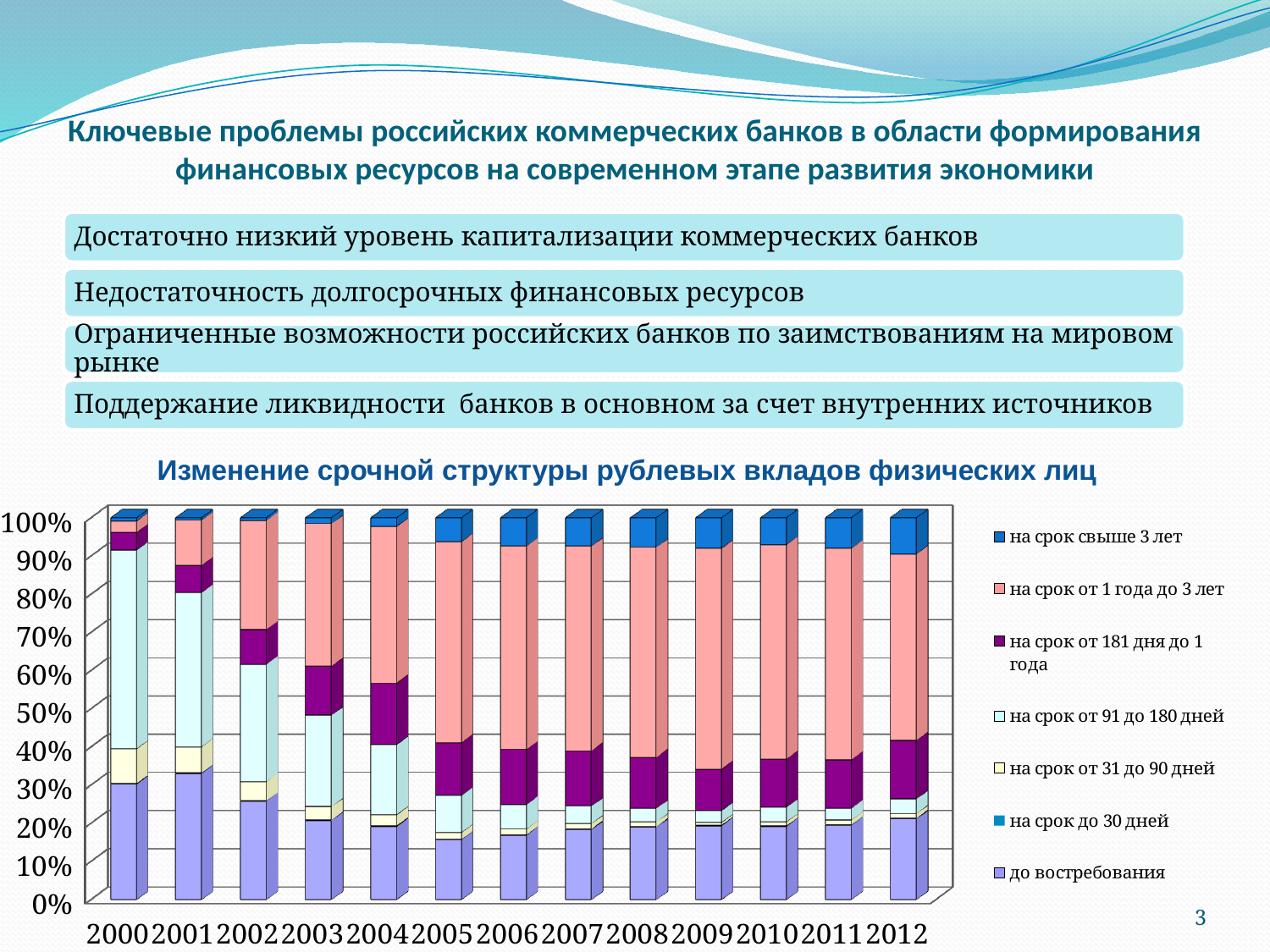
What is the total of the stacked bar for 2005? 100% What is the title of the chart on the slide? Изменение срочной структуры рублевых вкладов физических лиц In 2000, which is larger: the share of 'на срок от 91 до 180 дней' or the share of 'на срок от 1 года до 3 лет'? на срок от 91 до 180 дней What kind of chart is shown on the slide? stacked bar chart Is the share of 'на срок свыше 3 лет' in 2000 greater or less than 10%? less How many years are shown along the x axis of the chart? 13 Is the share of 'на срок от 91 до 180 дней' in 2000 greater or less than 40%? greater Which legend entry is shown at the bottom of the legend? до востребования Does the share of 'на срок от 91 до 180 дней' rise or fall from 2000 to 2012? fall How many series does the chart legend list? 7 Is the share of 'на срок от 1 года до 3 лет' in 2012 greater or less than 40%? greater